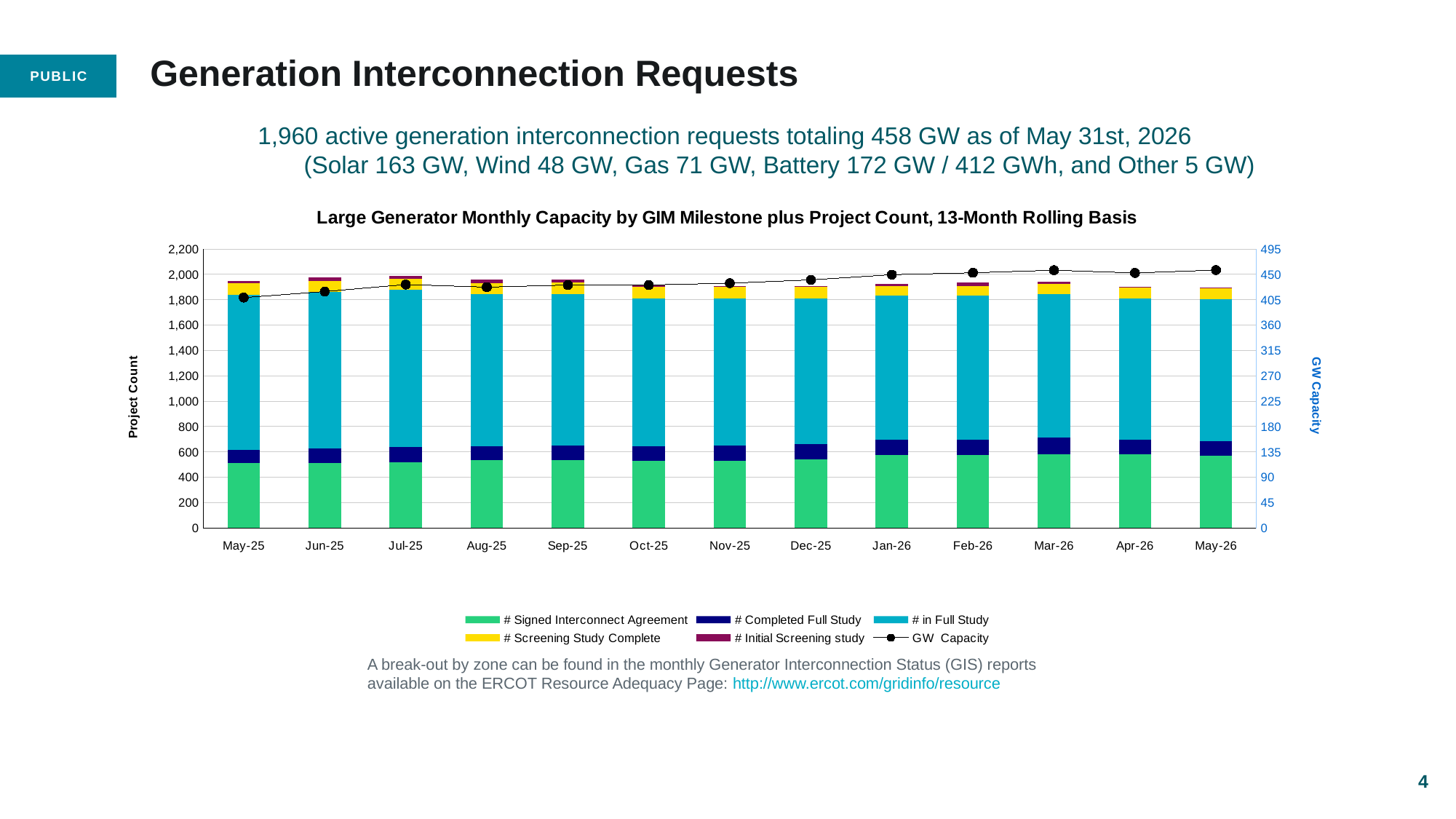
Is the GW Capacity value for May-25 greater or less than 450? less Does the GW Capacity line generally rise or fall from May-25 to May-26? Rise What is the title of the chart? Large Generator Monthly Capacity by GIM Milestone plus Project Count, 13-Month Rolling Basis Which series is plotted as a line with markers rather than as bars? GW Capacity How many series does the chart's legend list? 6 What kind of chart is shown on the slide? Stacked bar chart with a line Is the total project count (full stacked bar) for Apr-26 greater or less than 2,000? less Is the # Signed Interconnect Agreement value for May-25 greater or less than 400? greater Which month has the lowest GW Capacity value? May-25 How many months are shown on the x axis of the chart? 13